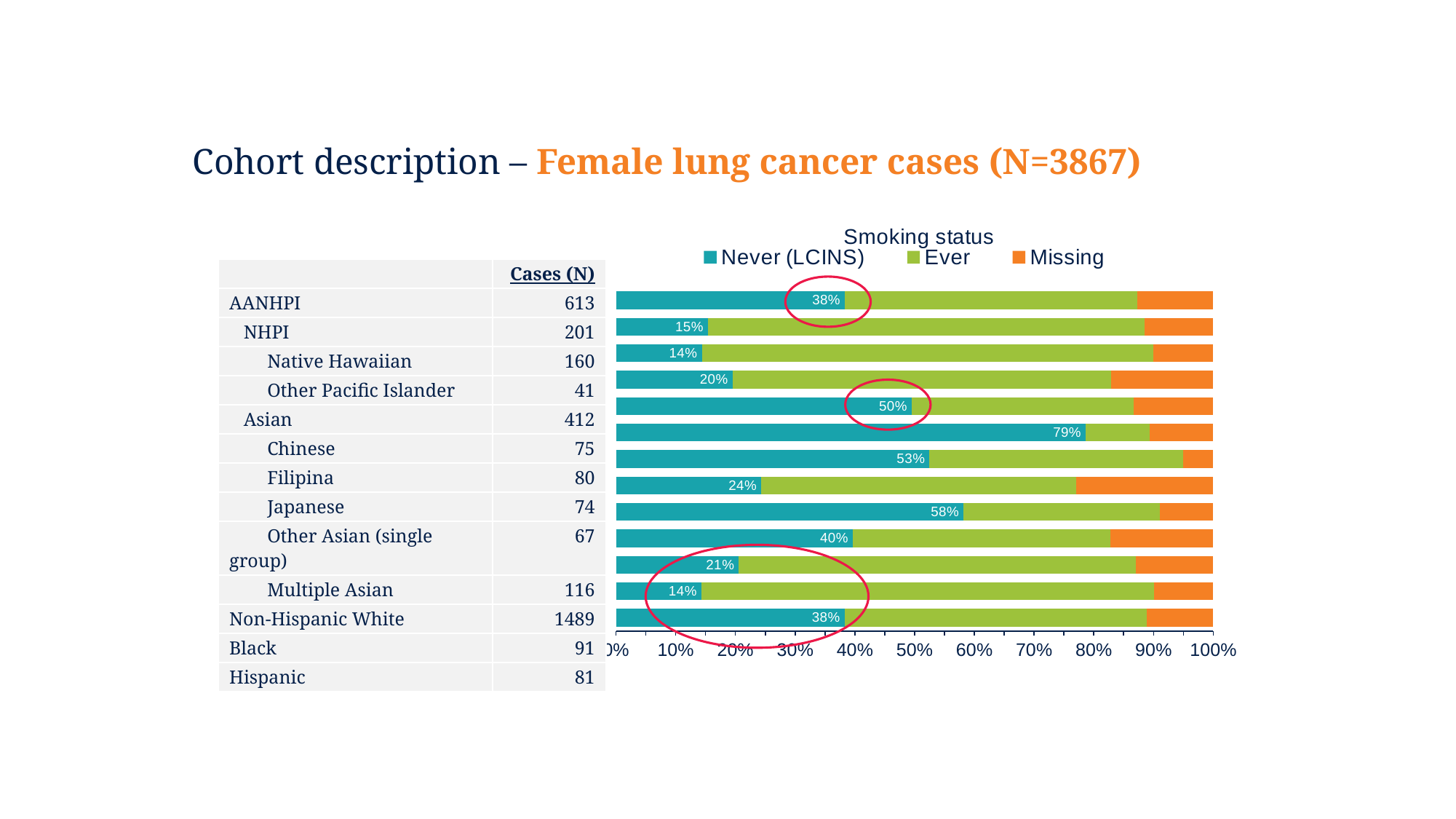
What is the title shown above the chart legend? Smoking status What kind of chart is shown on the slide? Stacked bar chart What is the lowest Never (LCINS) percentage labelled on any bar? 14% What is the highest Never (LCINS) percentage labelled on any bar? 79% What Never (LCINS) percentage is labelled on the sixth bar from the top? 79% What Never (LCINS) percentage is labelled on the bottom bar of the chart? 38% What is the difference between the highest and lowest Never (LCINS) percentages labelled on the chart? 65 percentage points How many bars are plotted in the chart? 13 How many series does the chart legend list? 3 What are the three legend entries of the chart? Never (LCINS), Ever, Missing What Never (LCINS) percentage is labelled on the top bar of the chart? 38% Which has the larger Never (LCINS) share, the top bar or the second bar from the top? The top bar